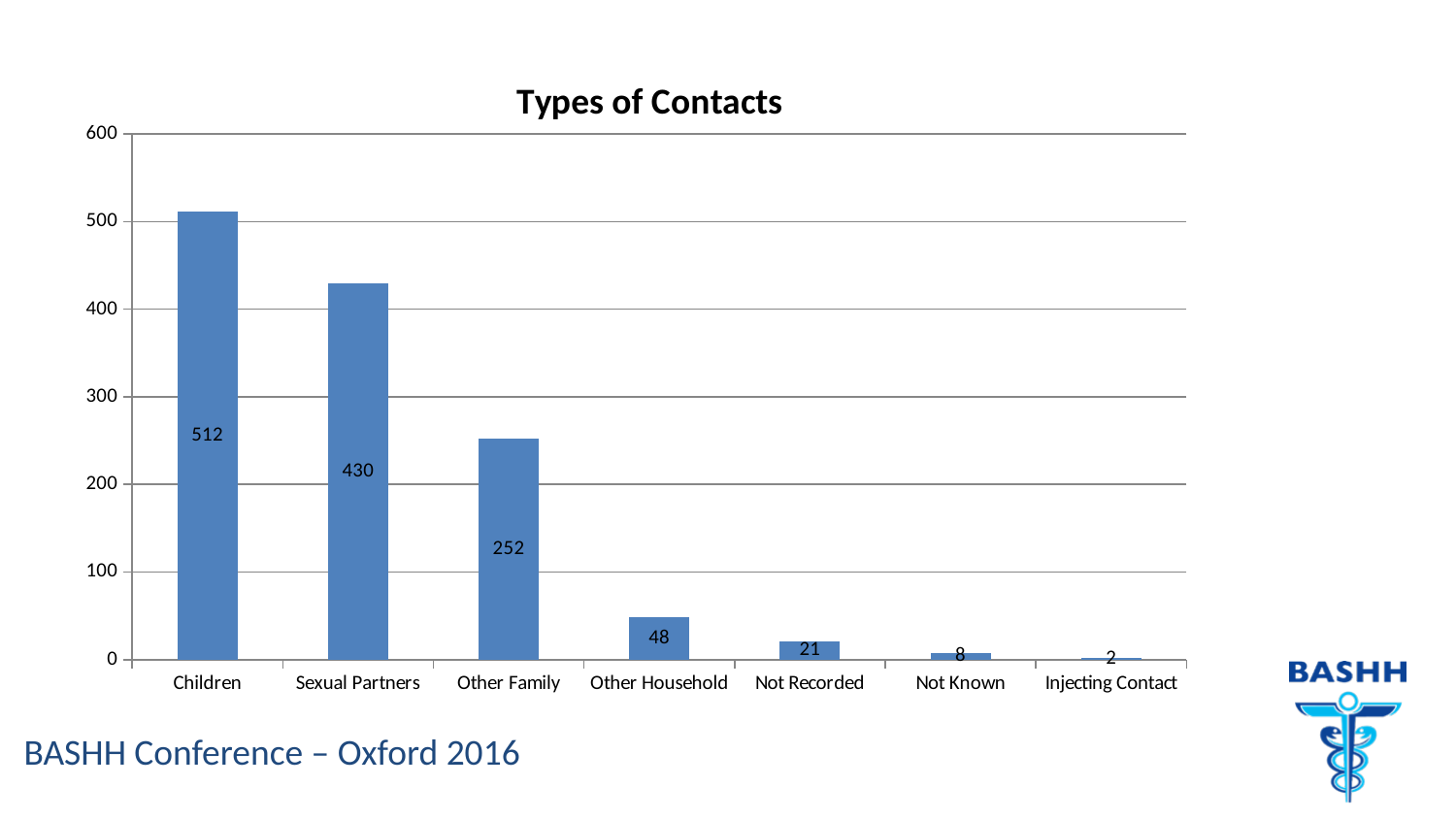
Which is larger, the value for Other Family or the value for Not Known? Other Family What is the value for Children? 512 What kind of chart is this? bar chart What is the difference between the values for Other Family and Other Household? 204 Which category has the highest value? Children Which category has the lowest value? Injecting Contact Is the value for Sexual Partners greater or less than 400? greater What is the value for Other Household? 48 How many categories are shown on the chart? 7 What is the difference between the values for Children and Sexual Partners? 82 What is the value for Sexual Partners? 430 What is the value for Not Recorded? 21